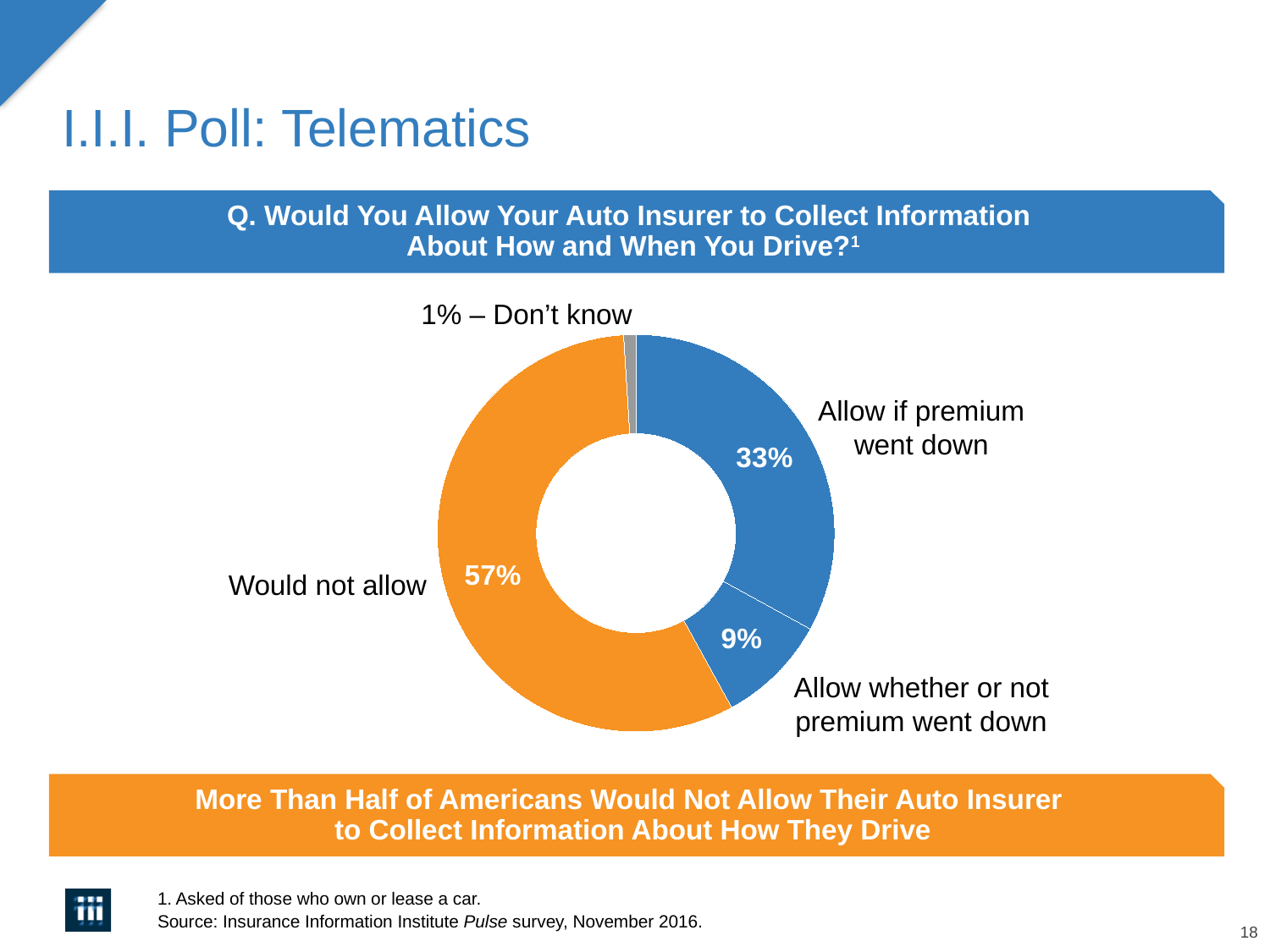
Which response category has the smallest share of the chart? Don't know What percentage of respondents would allow data collection whether or not their premium went down? 9% How many response categories are shown in the chart? 4 What colour is the 'Would not allow' segment of the chart? Orange What percentage of respondents would allow data collection if their premium went down? 33% What is the combined percentage of respondents who would allow data collection (with or without a premium decrease)? 42% What is the difference in percentage points between 'Would not allow' and 'Allow if premium went down'? 24 What percentage of respondents answered 'Don't know'? 1% Which response category has the largest share of the chart? Would not allow What kind of chart is shown on the slide? Doughnut (pie) chart What percentage of respondents would not allow their auto insurer to collect information about how and when they drive? 57% Which is larger: the share for 'Allow if premium went down' or the share for 'Allow whether or not premium went down'? Allow if premium went down